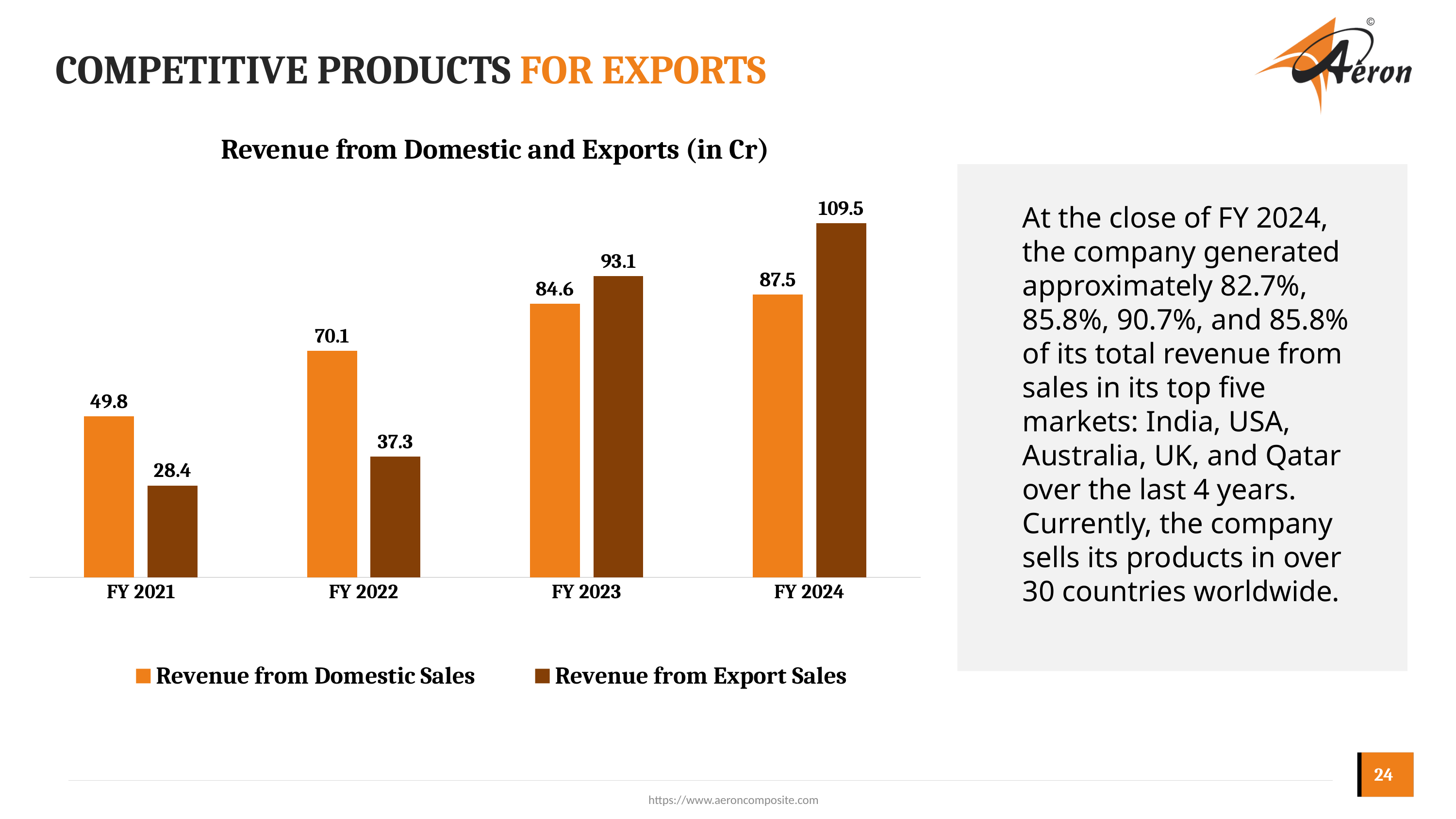
What is the difference between Revenue from Export Sales and Revenue from Domestic Sales in FY 2024? 22 What is the Revenue from Export Sales for FY 2022? 37.3 What is the difference between Revenue from Domestic Sales in FY 2022 and FY 2021? 20.3 Which fiscal year has the lowest Revenue from Domestic Sales? FY 2021 What kind of chart is shown on the slide? Bar chart Which fiscal year has the highest Revenue from Export Sales? FY 2024 In FY 2023, which is larger: Revenue from Domestic Sales or Revenue from Export Sales? Revenue from Export Sales Does Revenue from Export Sales rise or fall from FY 2021 to FY 2024? Rise What is the Revenue from Export Sales for FY 2024? 109.5 What is the Revenue from Domestic Sales for FY 2021? 49.8 How many series does the chart legend list? 2 How many fiscal years are shown on the x axis of the chart? 4